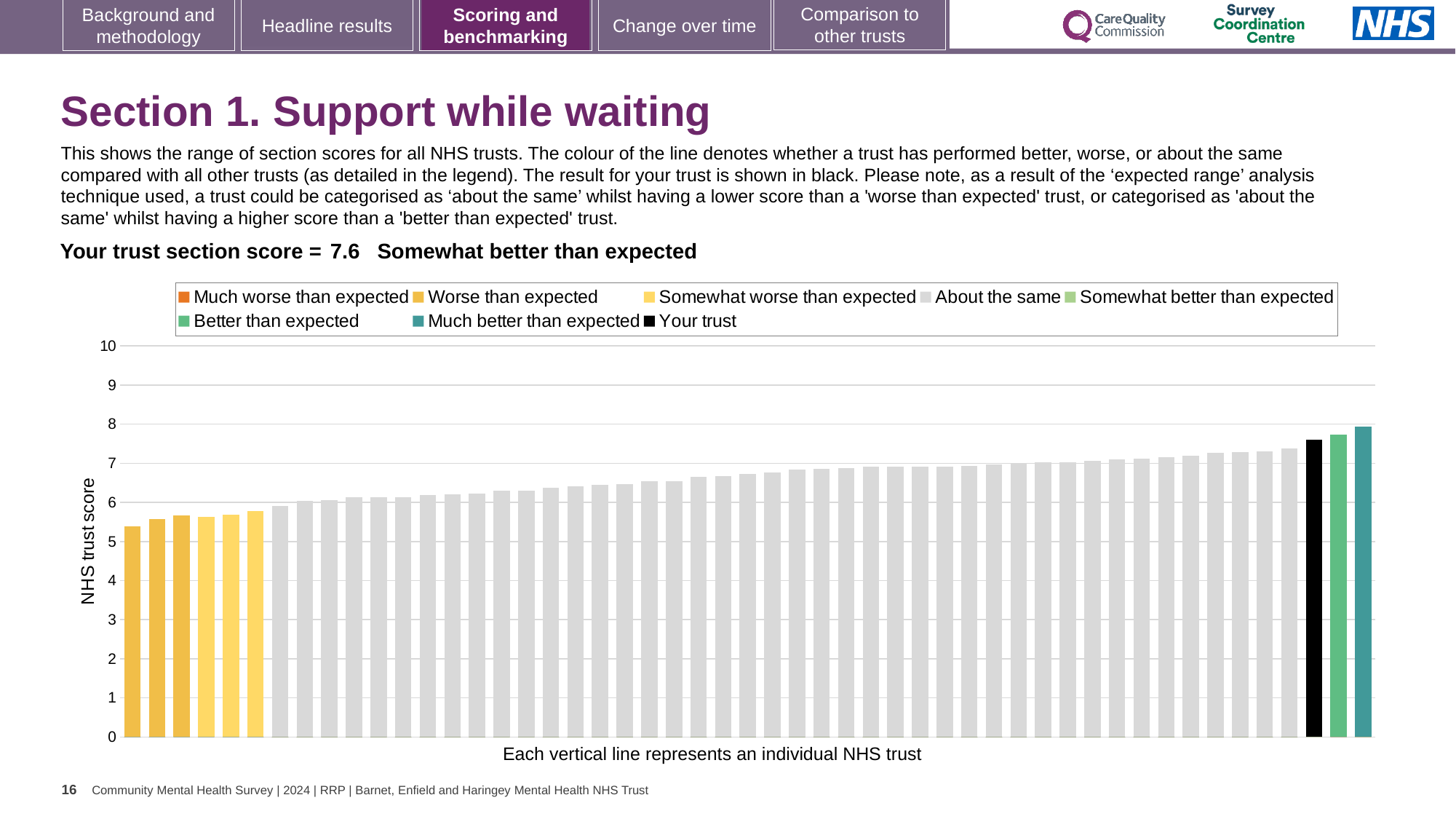
Is the value of the black 'Your trust' bar greater or less than 7? greater What kind of chart is shown on the slide? bar chart What is the highest value shown on the vertical axis? 10 Is the value of the leftmost (lowest) bar greater or less than 6? less How many bars are to the right of the black 'Your trust' bar? 2 What is the section score for your trust shown on the slide? 7.6 What colour is the bar representing your trust? black Do the bar values rise or fall from left to right along the x axis? rise Which category is your trust placed in for this section? Somewhat better than expected Which is larger: the black 'Your trust' bar or the leftmost bar? Your trust How many entries does the chart legend list? 8 What is the label on the vertical axis of the chart? NHS trust score